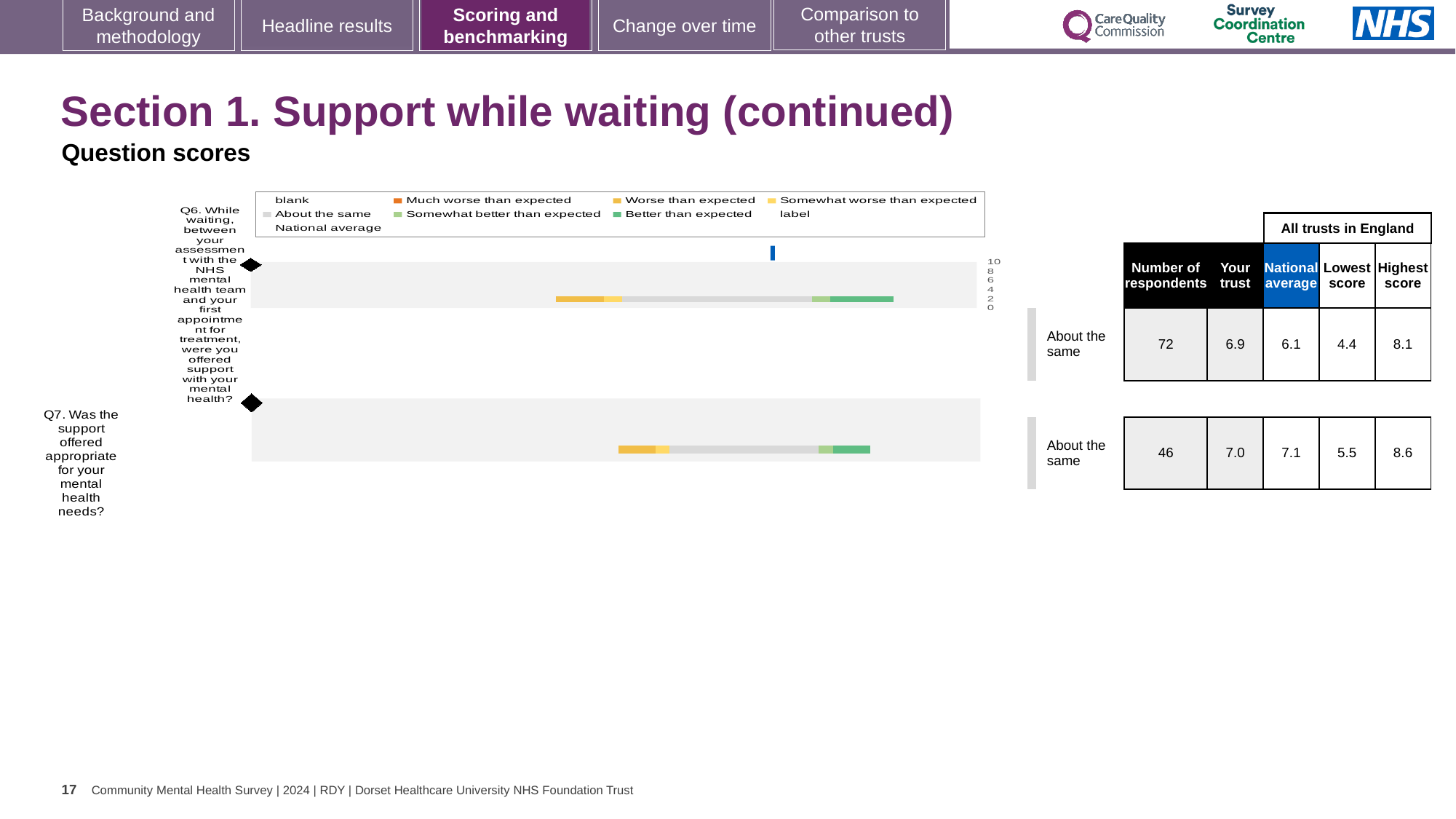
What is the 'Your trust' score for Q6 (support while waiting between assessment and first appointment)? 6.9 For Q6, which is larger: the 'Your trust' score or the national average? Your trust What benchmark category is shown for Q6? About the same How many respondents answered Q6? 72 What kind of chart is used to show the question scores on this slide? Bar chart How many questions are plotted in the chart? 2 What is the lowest score among all trusts in England for Q6? 4.4 Which question had more respondents, Q6 or Q7? Q6 What is the difference between the highest score and the lowest score for Q7? 3.1 What is the highest score among all trusts in England for Q7? 8.6 What is the national average score for Q7 (was the support offered appropriate for your mental health needs)? 7.1 What colour does the legend use for 'Better than expected'? Green